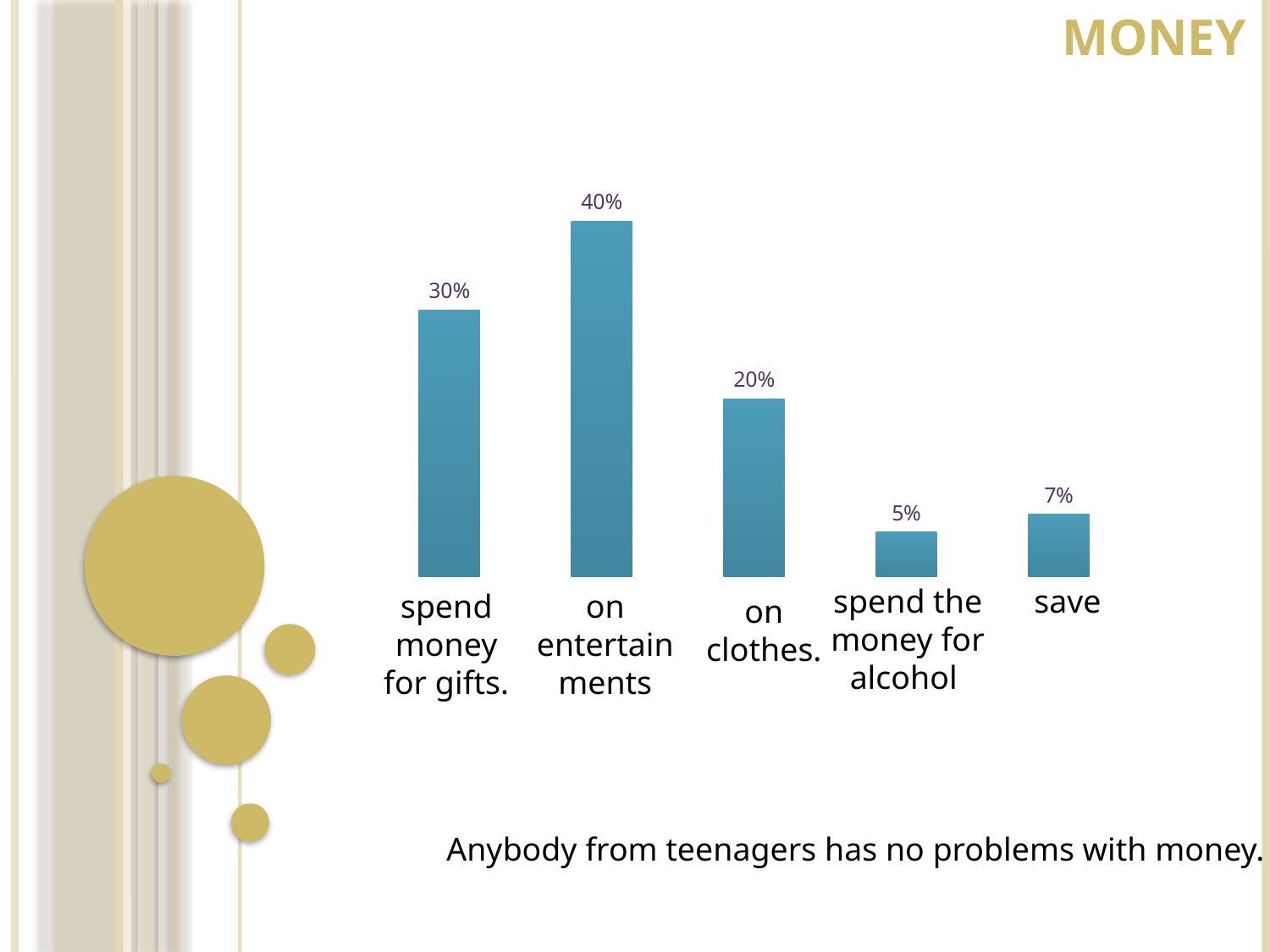
How many categories are shown in the chart? 5 What percentage is shown for 'on entertainments'? 40% Which category has the lowest value? spend the money for alcohol What percentage is shown for 'spend money for gifts.'? 30% What kind of chart is shown on the slide? bar chart What percentage is shown for 'spend the money for alcohol'? 5% What is the difference between the values for 'on entertainments' and 'on clothes.'? 20% Which category has the highest value? on entertainments Which is larger, the value for 'spend money for gifts.' or the value for 'on clothes.'? spend money for gifts. What is the difference between the values for 'save' and 'spend the money for alcohol'? 2% What is the title shown at the top of the slide? MONEY What percentage is shown for 'save'? 7%